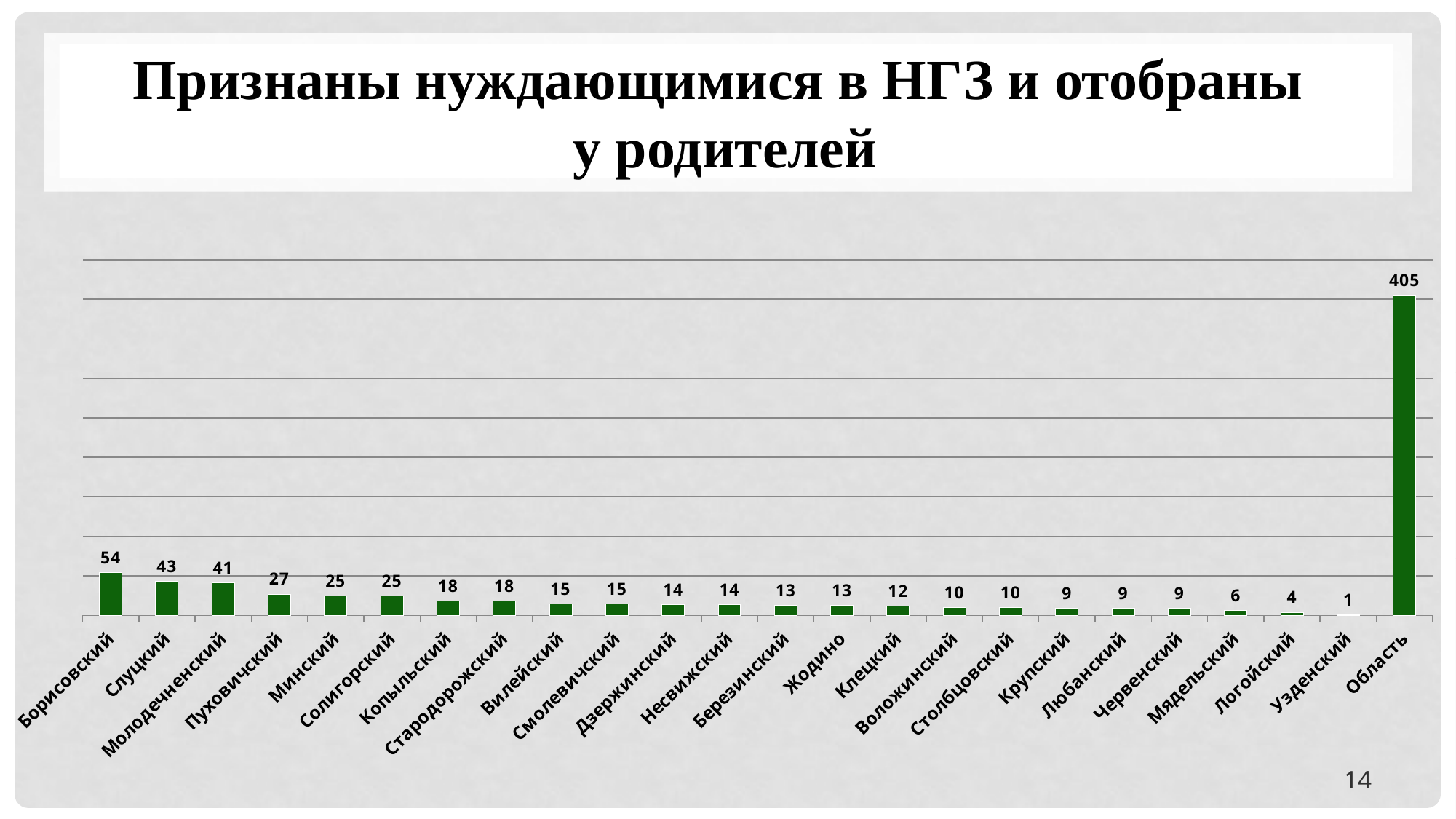
Which is larger, the value for Минский or the value for Копыльский? Минский Which category has the lowest value? Узденский What is the difference between the values for Борисовский and Слуцкий? 11 What is the difference between the values for Молодечненский and Пуховичский? 14 What is the value for Борисовский? 54 How many categories are shown on the x axis? 24 What is the value for Область? 405 What is the value for Узденский? 1 What is the value for Слуцкий? 43 What kind of chart is shown on the slide? Bar chart What colour are the bars in the chart? Green Which category has the highest value? Область